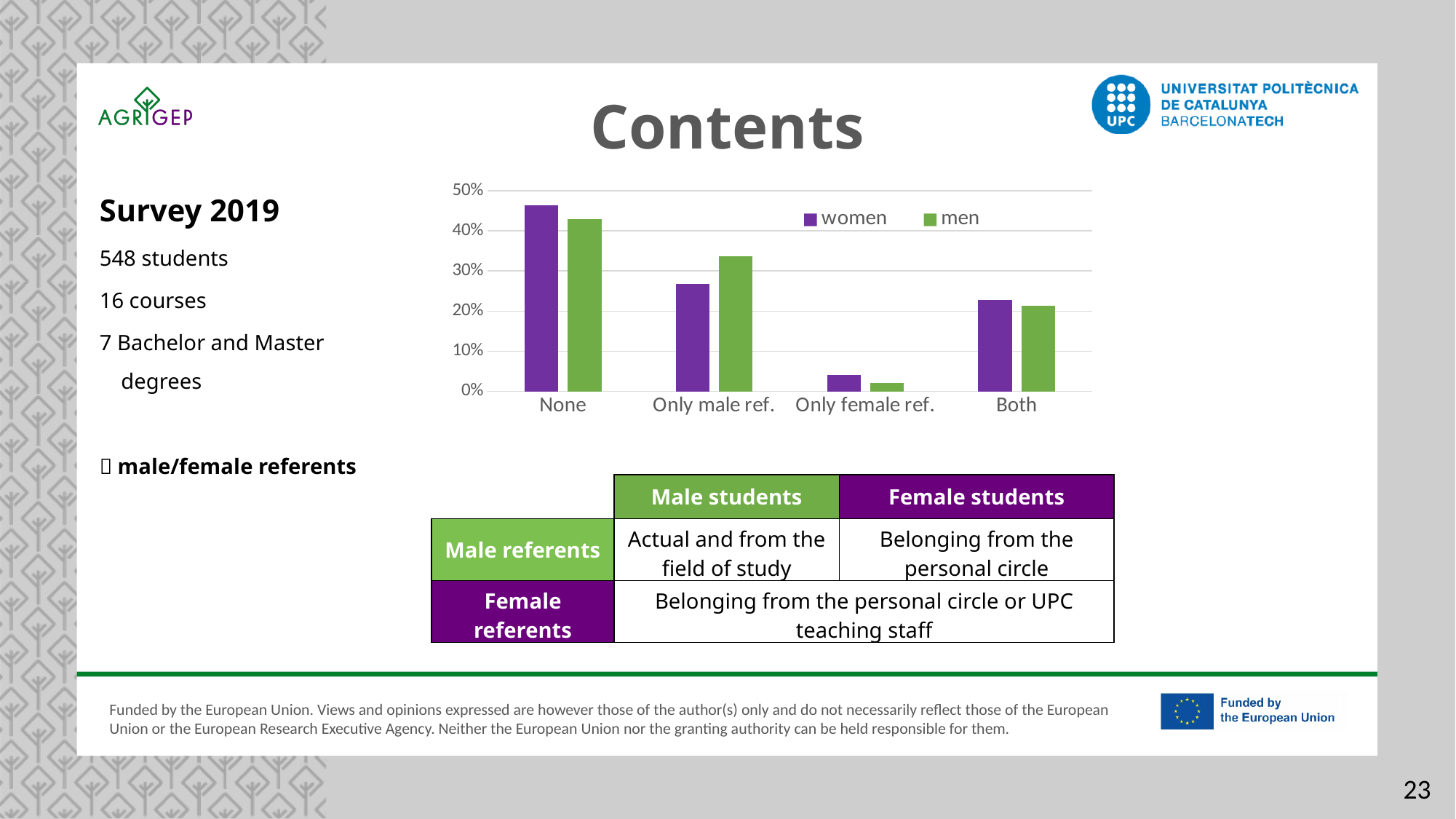
How many categories are shown on the x axis of the chart? 4 What kind of chart is shown on the slide? bar chart Is the value for women in the 'Only male ref.' category greater or less than 30%? less For the 'Only male ref.' category, which series has the larger value, women or men? men Which category has the lowest value for women? Only female ref. For the 'Only female ref.' category, which series has the larger value, women or men? women Which colour represents the 'women' series in the chart? purple Which category has the lowest value for men? Only female ref. Is the value for women in the 'None' category greater or less than 40%? greater How many series does the chart legend list? 2 Is the value for men in the 'Only female ref.' category greater or less than 10%? less Which category has the highest value for women? None